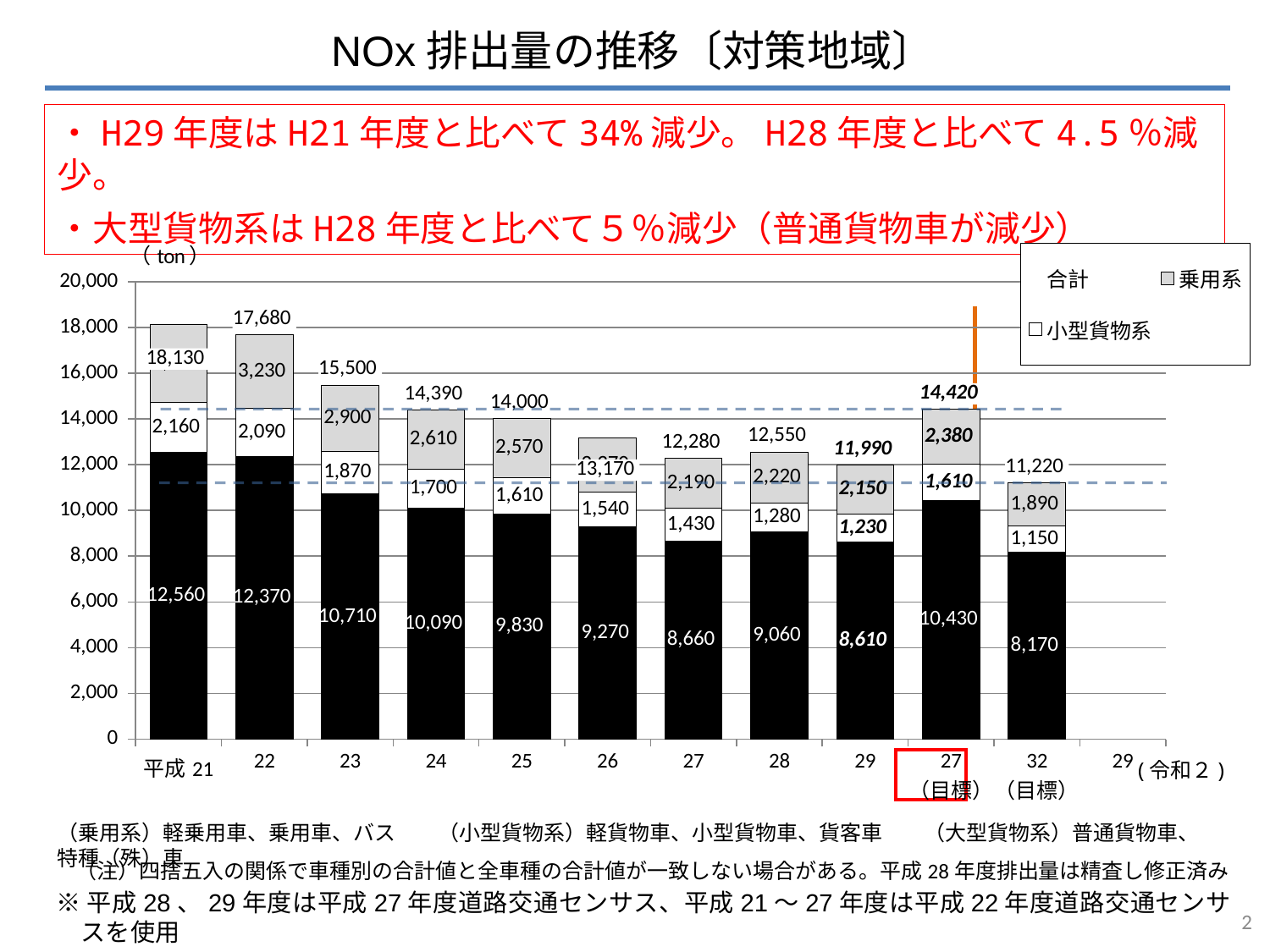
Do the total values generally rise or fall from 平成21 to 平成29? Fall What type of chart is shown on the slide? Stacked bar chart Which year has the highest total NOx emission? 平成21 What is the difference between the total for 平成28 (12,550) and 平成29 (11,990)? 560 What is the total value labelled for 32（目標）? 11,220 How many bars are plotted in the chart? 11 What is the title of the chart? NOx排出量の推移〔対策地域〕 What is the 乗用系 value for 平成28? 2,220 Which bar has the lowest total value? 32（目標） What is the 小型貨物系 value for 平成25? 1,610 What is the total NOx emission value labelled for 平成21? 18,130 Which is larger, the total for 平成27 or the total for 平成28? 平成28